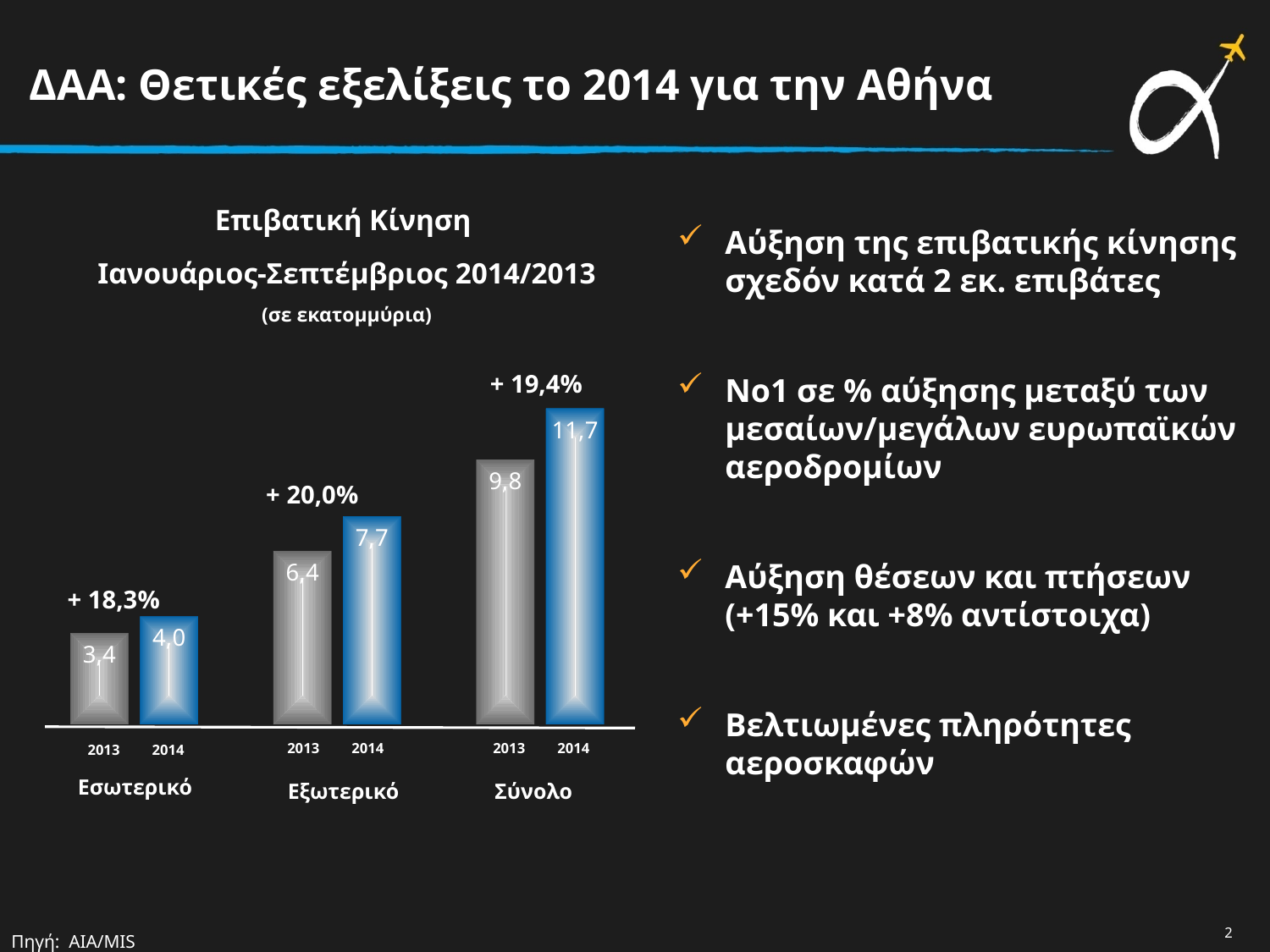
What is the value for Σύνολο in 2013? 9,8 Which is larger, the Εξωτερικό value for 2013 or the Εσωτερικό value for 2014? Εξωτερικό 2013 What is the value for Εσωτερικό in 2013? 3,4 Which bar has the highest value in the chart? Σύνολο 2014 What is the value for Εσωτερικό in 2014? 4,0 What is the difference between the Σύνολο values for 2014 and 2013? 1,9 What percentage change is shown above the Εξωτερικό bars? + 20,0% Which bar has the lowest value in the chart? Εσωτερικό 2013 What unit does the chart subtitle say the values are in? σε εκατομμύρια What is the value for Εξωτερικό in 2014? 7,7 How many category groups are shown on the x axis of the chart? 3 What type of chart is shown on the slide? bar chart